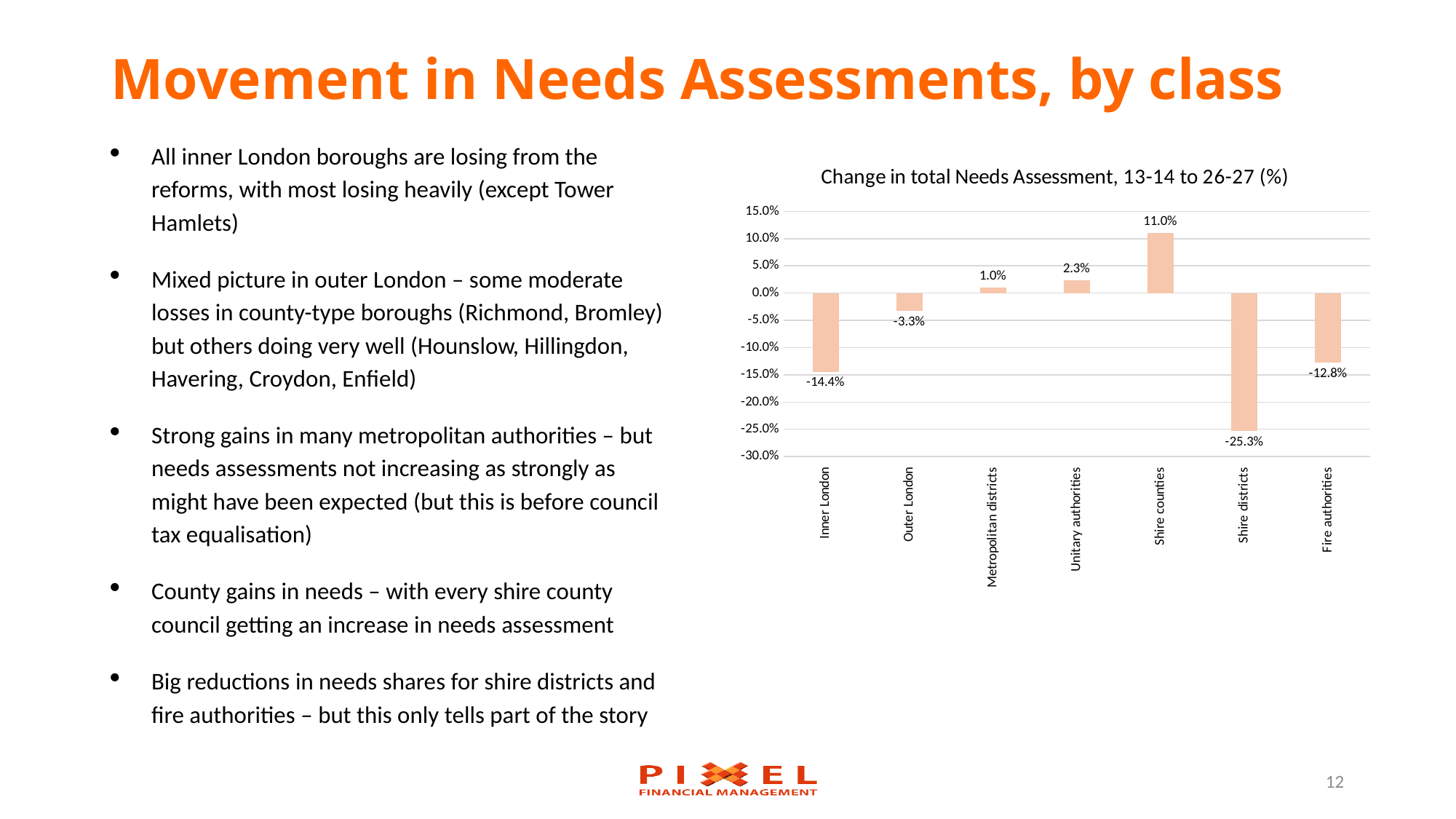
What is the value for Shire counties? 11.0% What is the value for Unitary authorities? 2.3% What kind of chart is shown on the slide? Bar chart Which category has the lowest value? Shire districts What is the value for Inner London? -14.4% What is the value for Fire authorities? -12.8% What is the difference between the values for Shire counties and Unitary authorities? 8.7% What is the title of the chart? Change in total Needs Assessment, 13-14 to 26-27 (%) Which is larger, the value for Metropolitan districts or the value for Unitary authorities? Unitary authorities What is the difference between the values for Inner London and Fire authorities? 1.6% How many categories are shown on the x axis? 7 Which category has the highest value? Shire counties